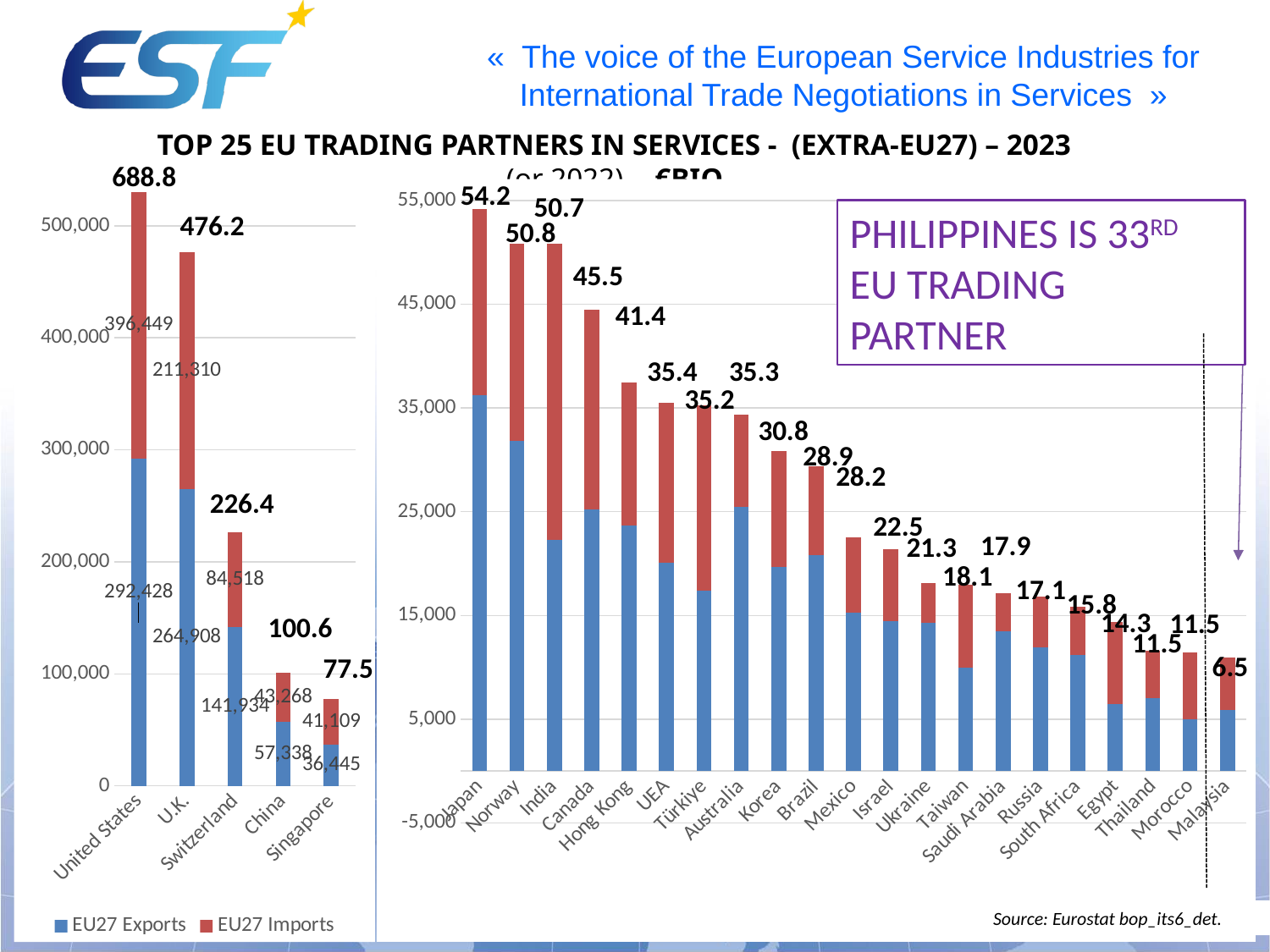
On the left chart, what is the difference between the totals labelled for the United States and the U.K.? 212.6 On the left chart, which country has the lowest total value? Singapore On the right chart, is the value for Malaysia greater or less than 15,000? less On the left chart, which is larger for the United States: EU27 Exports or EU27 Imports? EU27 Imports On the right chart, do the values generally rise or fall from left to right? fall On the right chart, which country has the highest value? Japan How many countries are shown on the left chart? 5 On the left chart, what is the EU27 Exports value labelled for the U.K.? 264,908 On the left chart, what is the total value labelled for the United States? 688.8 How many series does the legend of the left chart list? 2 What kind of chart is the right chart? bar chart